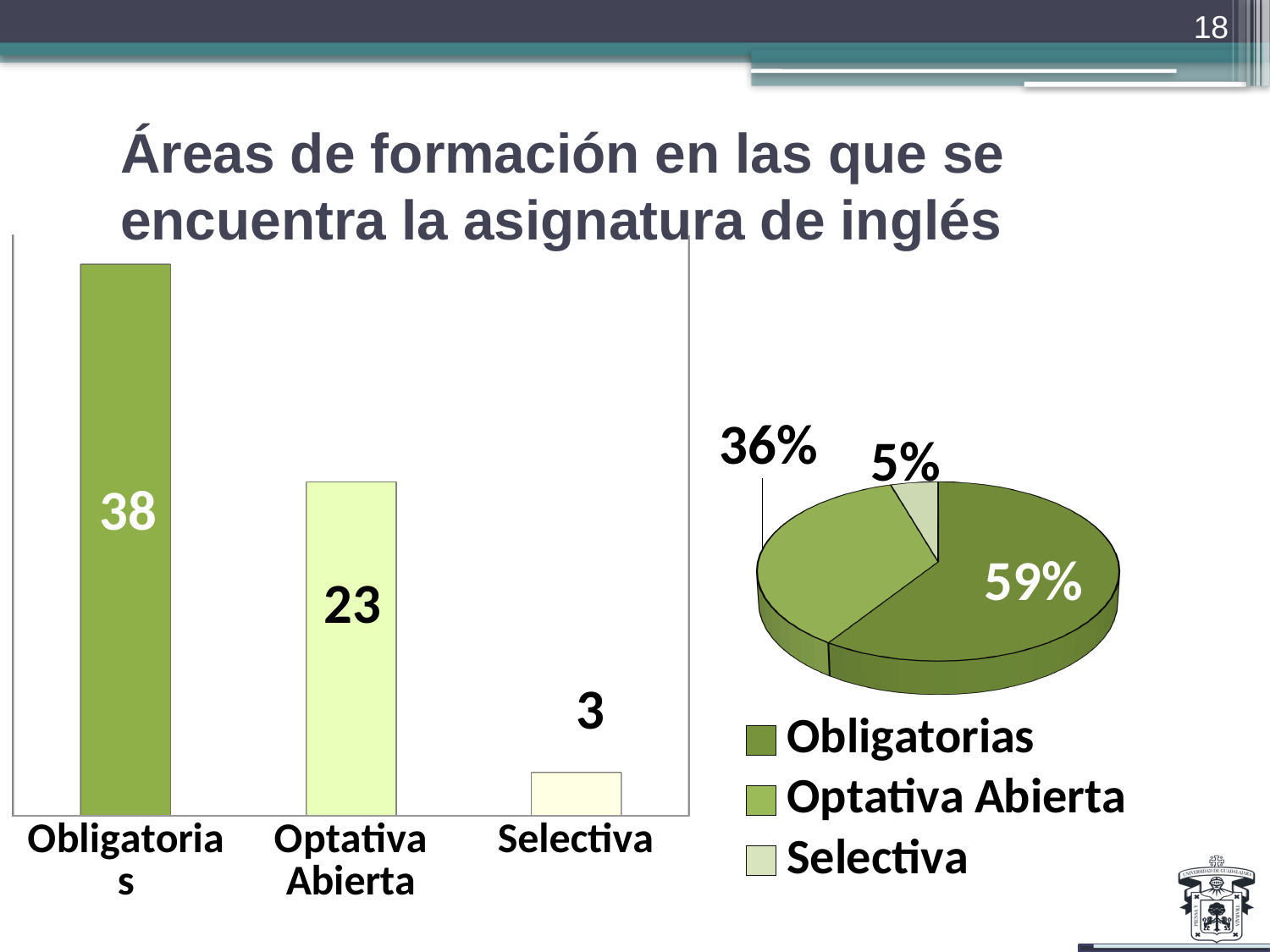
In the bar chart on the left, what is the value for Selectiva? 3 How many entries does the legend of the pie chart on the right list? 3 How many categories are shown in the bar chart on the left? 3 In the bar chart on the left, which category has the lowest value? Selectiva In the pie chart on the right, what share does Obligatorias have? 59% What kind of chart is on the left side of the slide? Bar chart In the bar chart on the left, what is the difference between the values for Obligatorias and Optativa Abierta? 15 In the bar chart on the left, which category has the highest value? Obligatorias In the bar chart on the left, which is larger, the value for Optativa Abierta or the value for Selectiva? Optativa Abierta In the bar chart on the left, what is the value for Obligatorias? 38 In the pie chart on the right, what share does Selectiva have? 5% In the bar chart on the left, what is the value for Optativa Abierta? 23